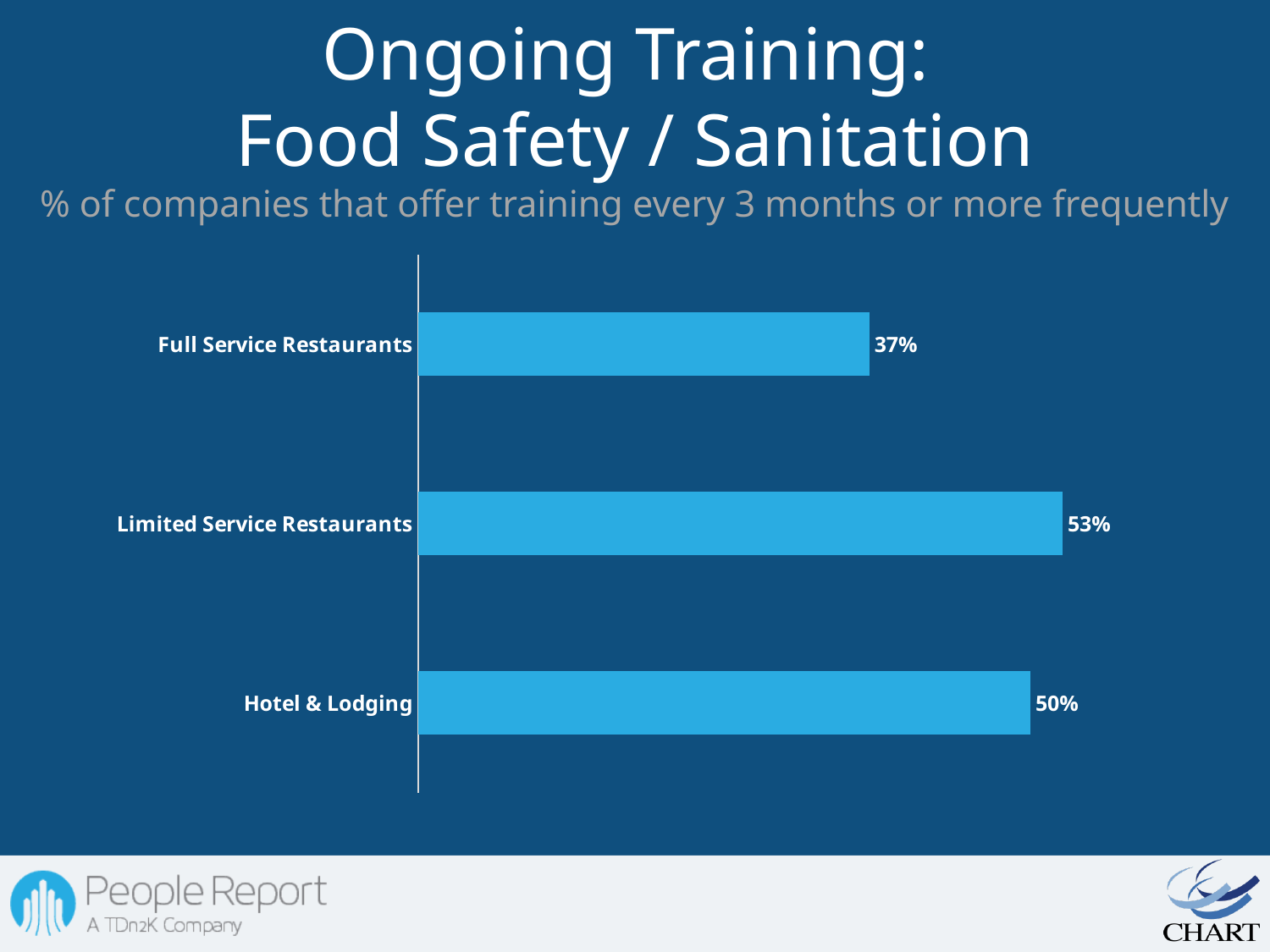
What does the subtitle say the chart measures? % of companies that offer training every 3 months or more frequently What percentage of Full Service Restaurants offer food safety / sanitation training every 3 months or more frequently? 37% Which category has the lowest percentage? Full Service Restaurants What is the difference in percentage points between Limited Service Restaurants and Full Service Restaurants? 16 What is the difference in percentage points between Hotel & Lodging and Full Service Restaurants? 13 What type of chart is shown on the slide? Bar chart Which is larger, the value for Hotel & Lodging or the value for Full Service Restaurants? Hotel & Lodging How many categories are shown in the chart? 3 What is the title of the slide? Ongoing Training: Food Safety / Sanitation Which category has the highest percentage? Limited Service Restaurants What is the value shown for Hotel & Lodging? 50% What is the value shown for Limited Service Restaurants? 53%